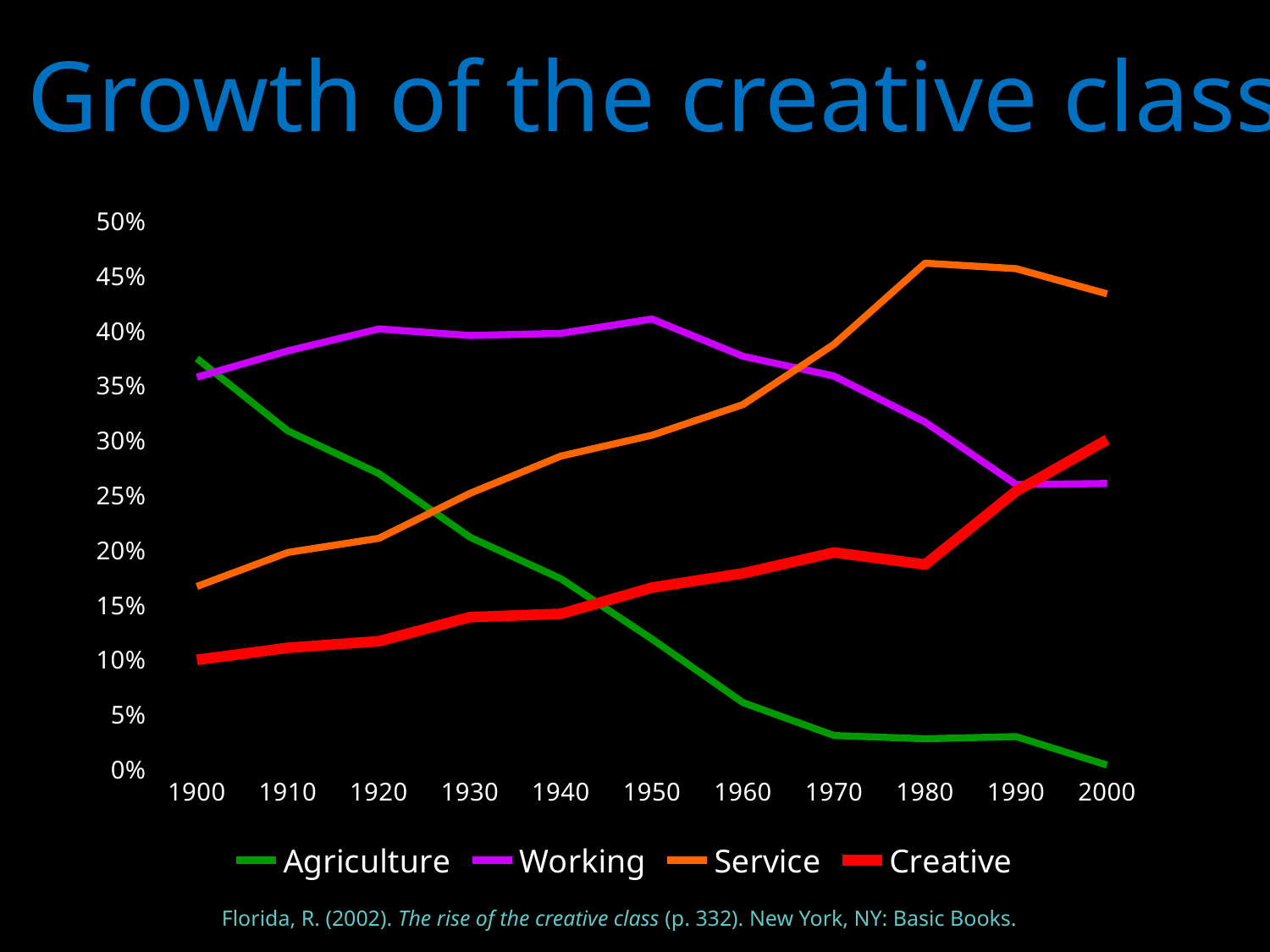
In 2000, which is larger, the Service value or the Working value? Service Does the Service line rise or fall from 1900 to 1980? rise Does the Agriculture line rise or fall from 1900 to 2000? fall How many years are marked along the x axis? 11 Is the value for Service in 1980 greater or less than 40%? greater Which series has the lowest value in 2000? Agriculture What kind of chart is shown on the slide? line chart Is the value for Agriculture in 1900 greater or less than 35%? greater Is the value for Creative in 2000 greater or less than 25%? greater How many series does the legend list? 4 Which series has the highest value in 1950? Working